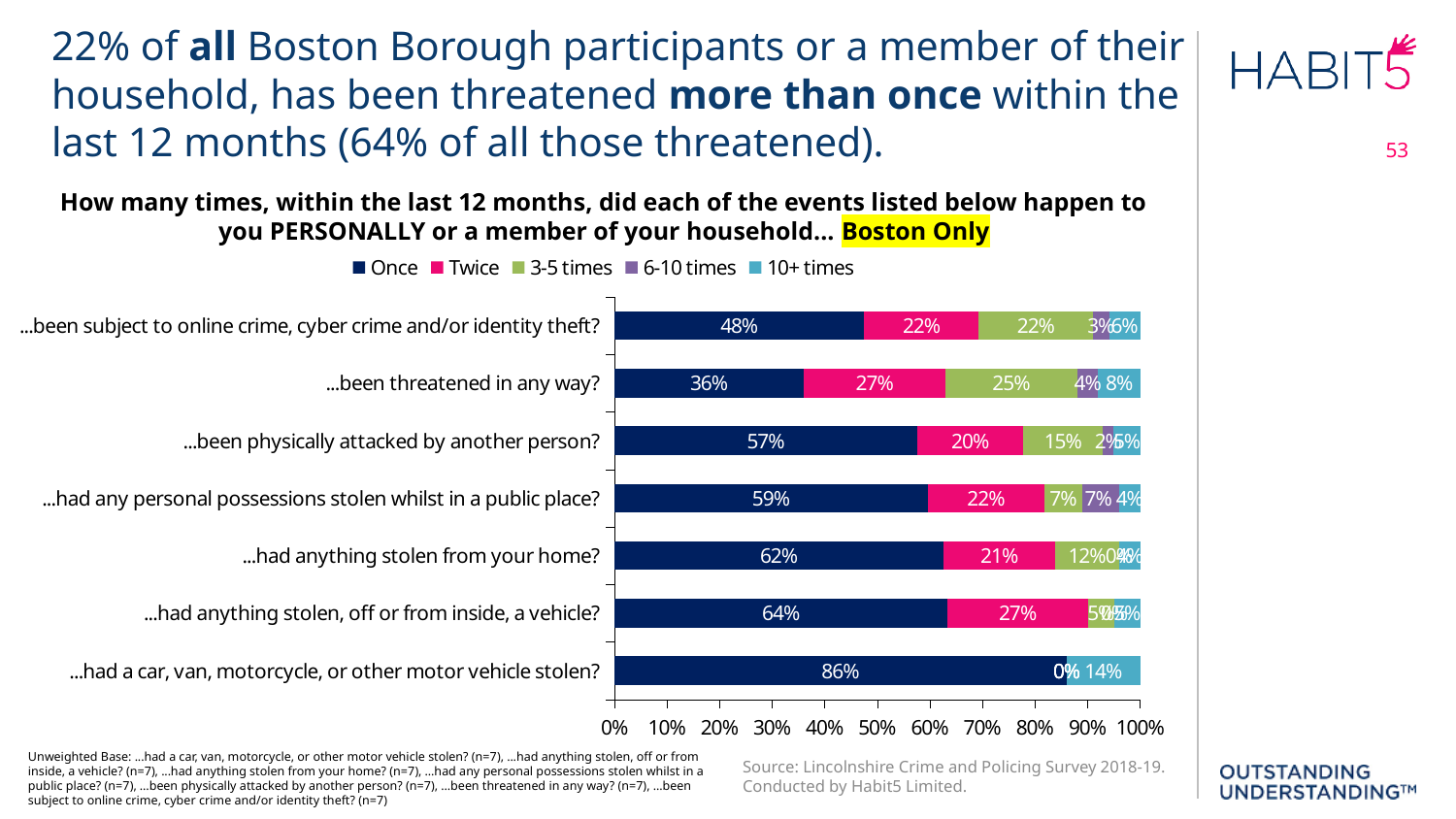
How many series does the legend list? 5 What is the 'Twice' value for '...had anything stolen, off or from inside, a vehicle?' 27% Which series is shown in dark blue in the legend? Once How many event categories are plotted on the chart? 7 Which category has the highest 'Once' value? ...had a car, van, motorcycle, or other motor vehicle stolen? What kind of chart is shown on the slide? stacked bar chart Which is larger: the 'Twice' value for '...been threatened in any way?' or the 'Twice' value for '...been physically attacked by another person?' ...been threatened in any way? What is the '3-5 times' value for '...been physically attacked by another person?' 15% What is the 'Once' value for '...been threatened in any way?' 36% What is the '10+ times' value for '...had a car, van, motorcycle, or other motor vehicle stolen?' 14% What is the difference between the 'Once' values for '...had anything stolen from your home?' and '...been subject to online crime, cyber crime and/or identity theft?' 14% Which category has the lowest 'Once' value? ...been threatened in any way?